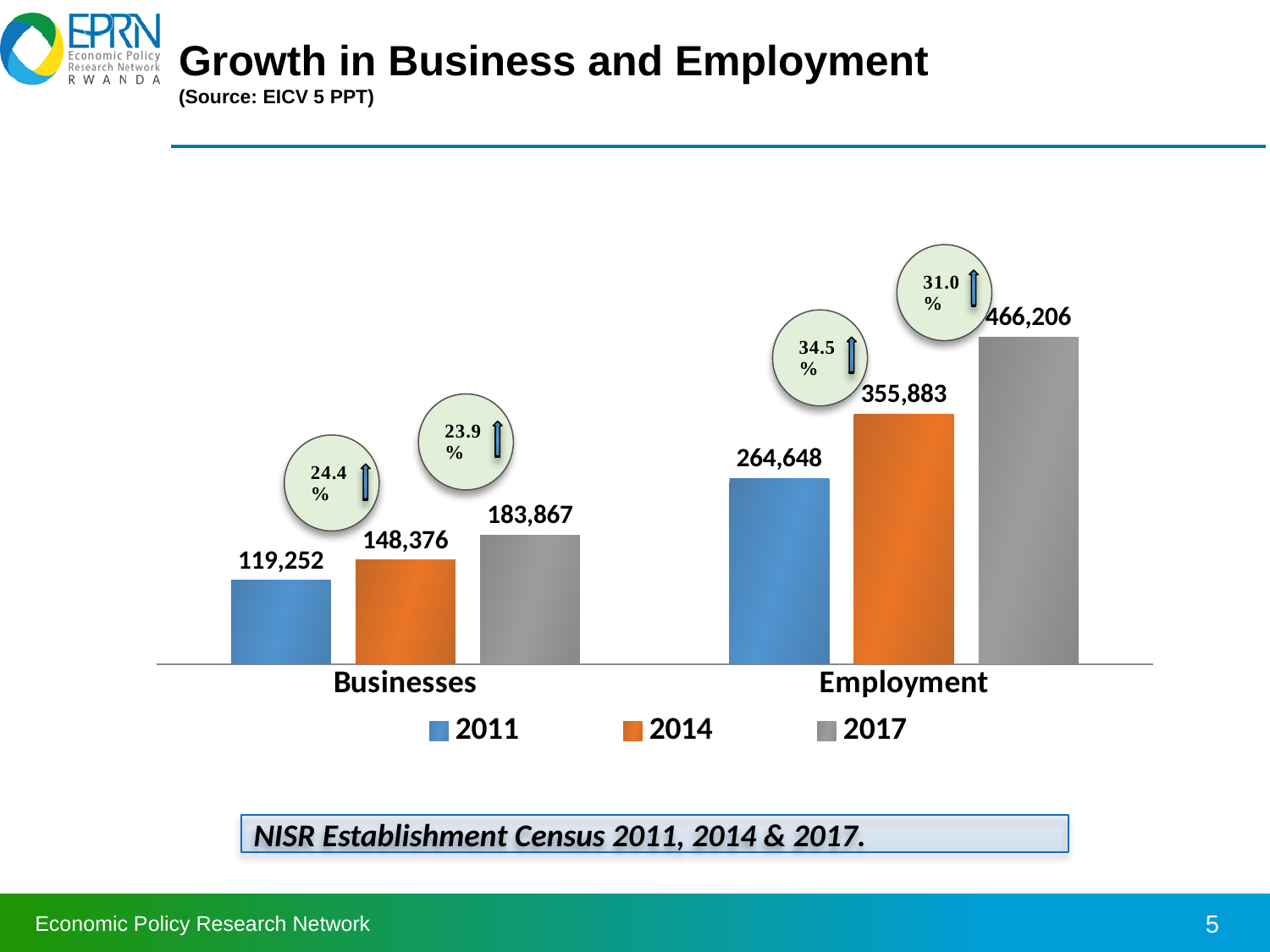
What is the value for Employment in 2017? 466,206 What is the difference between the Businesses values for 2014 and 2011? 29,124 What is the value for Employment in 2014? 355,883 Which year has the lowest value for Businesses? 2011 What is the difference between the Employment values for 2017 and 2014? 110,323 What is the value for Businesses in 2011? 119,252 What growth percentage is shown between 2014 and 2017 for Employment? 31.0% What is the value for Businesses in 2014? 148,376 How many series does the legend list? 3 Which is larger: Businesses in 2017 or Employment in 2011? Employment in 2011 Which year has the highest value for Employment? 2017 What kind of chart is shown on the slide? Bar chart